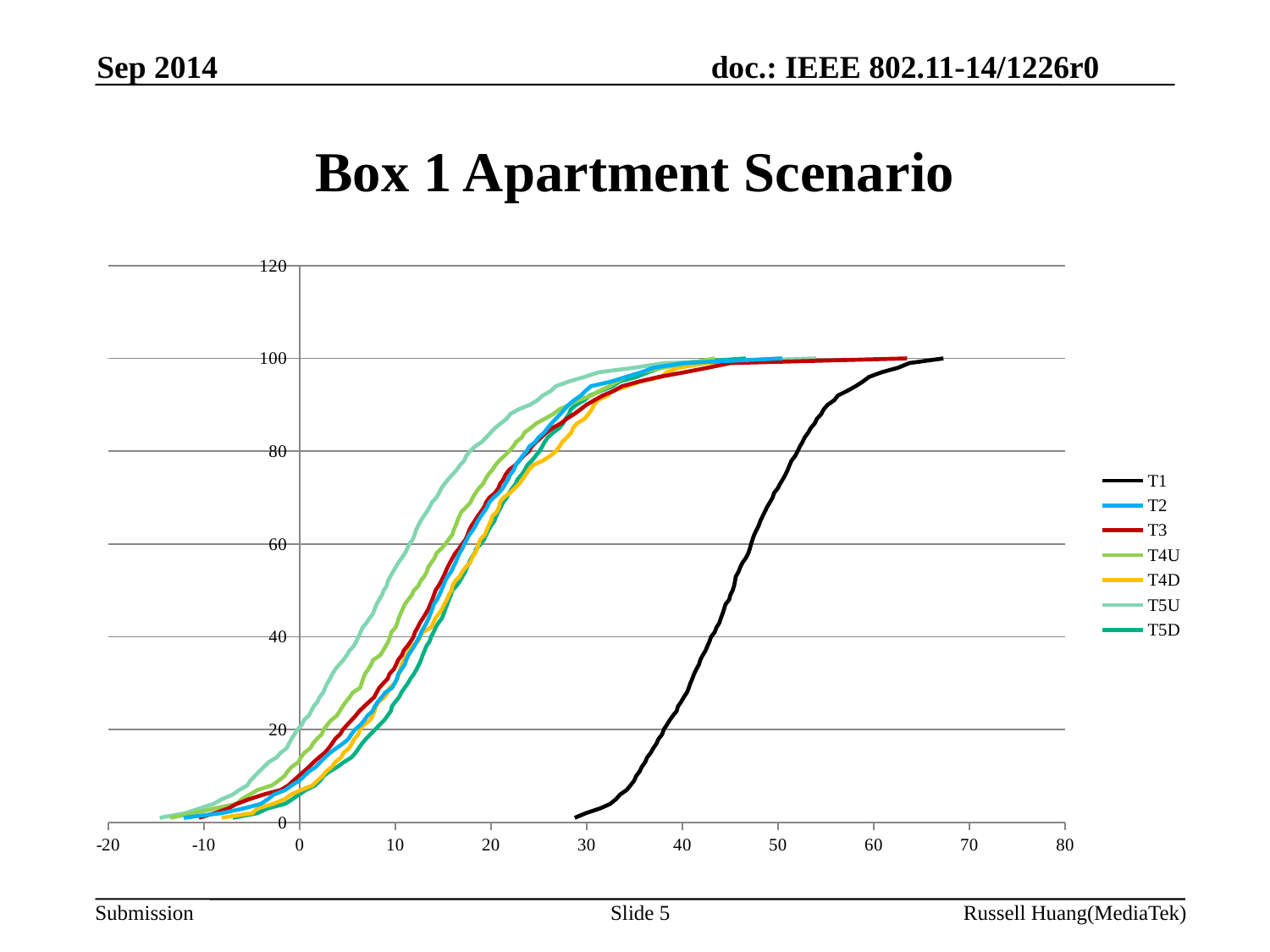
What kind of chart is shown on the slide? line chart At x = 40, which series has the larger value, T1 or T2? T2 Do the values of the T1 series rise or fall as x increases? rise Is the value of the T1 series at x = 30 greater or less than 20? less What is the title of the chart? Box 1 Apartment Scenario How many series does the legend list? 7 Is the value of the T2 series at x = 10 greater or less than 40? less Which series reaches 100 at the largest x value? T1 Is the value of the T1 series at x = 40 greater or less than 40? less Which series is drawn in black? T1